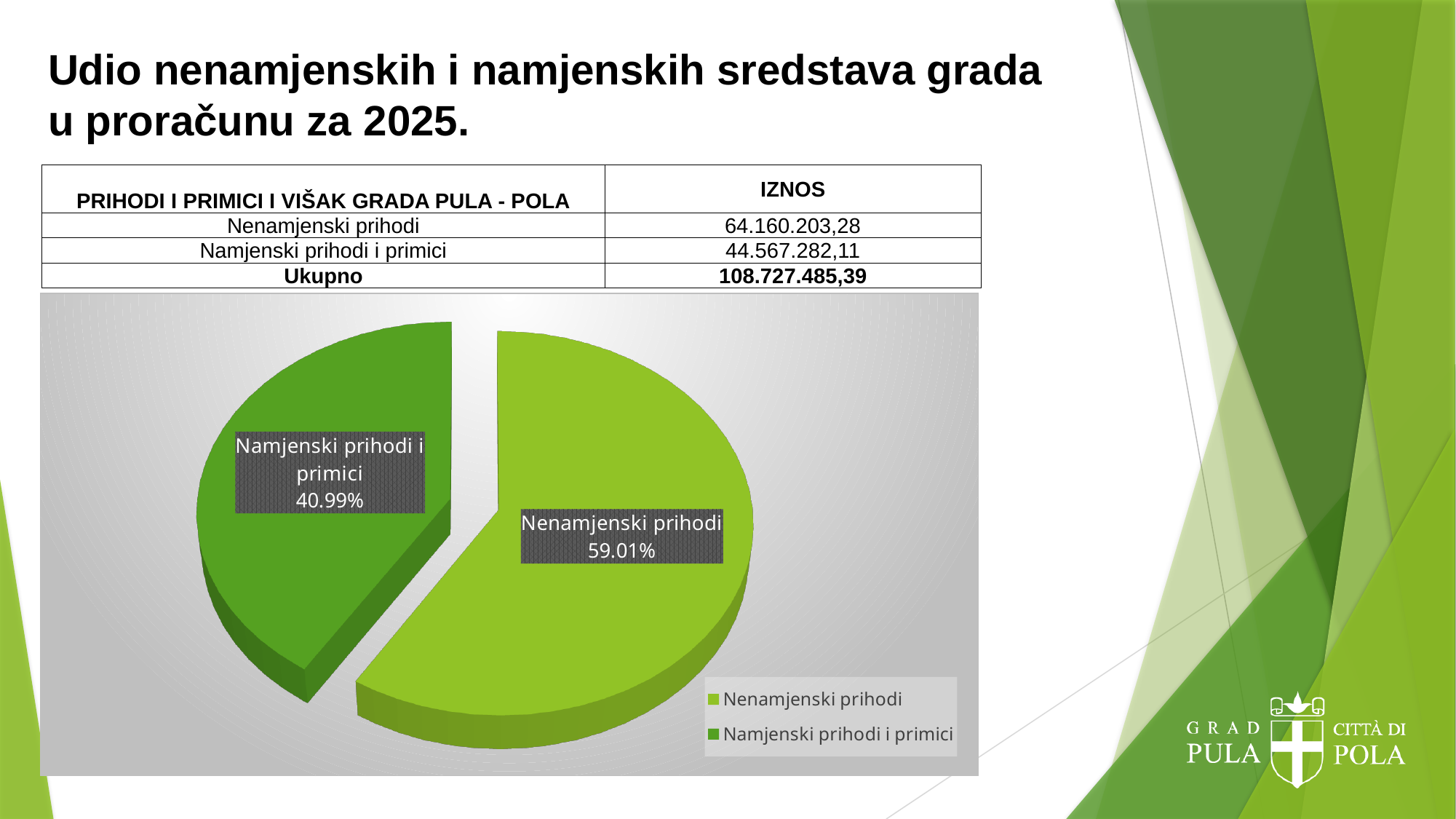
Is the share for Nenamjenski prihodi greater or less than 50%? greater Which slice of the pie is the smallest? Namjenski prihodi i primici What is the difference in percentage points between the Nenamjenski prihodi slice and the Namjenski prihodi i primici slice? 18.02% How many entries does the legend list? 2 What kind of chart is shown on the slide? pie chart Which legend entry is shown in the lighter green colour? Nenamjenski prihodi Which slice of the pie is the largest? Nenamjenski prihodi Which is larger: the share for Nenamjenski prihodi or the share for Namjenski prihodi i primici? Nenamjenski prihodi What share of the pie does Nenamjenski prihodi represent? 59.01% Where is the legend positioned in the chart? bottom right What share of the pie does Namjenski prihodi i primici represent? 40.99% How many slices does the pie chart have? 2